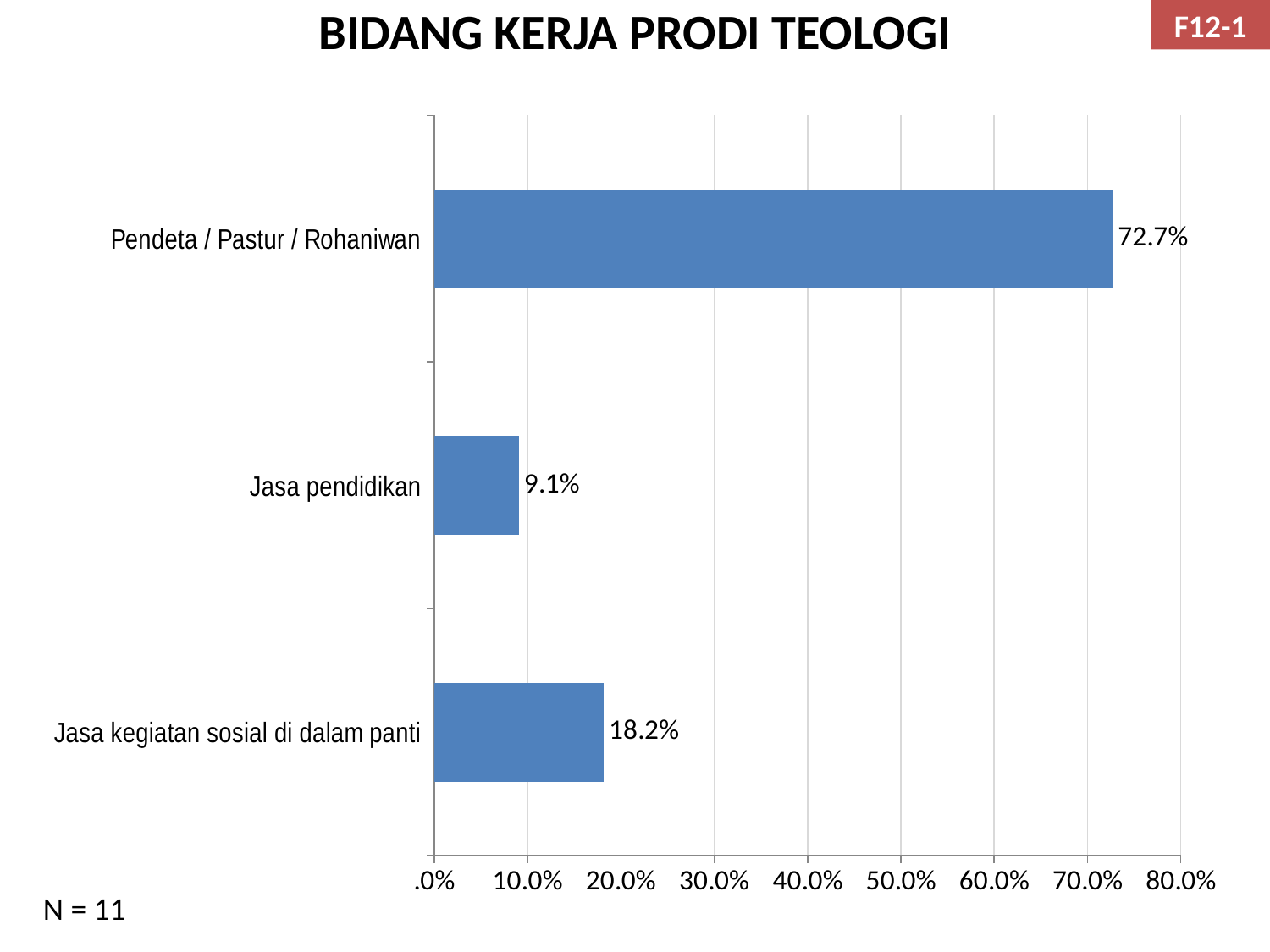
What is the difference between the values for Jasa kegiatan sosial di dalam panti and Jasa pendidikan? 9.1% What is the value for Pendeta / Pastur / Rohaniwan? 72.7% What is the value for Jasa kegiatan sosial di dalam panti? 18.2% Which category has the highest value? Pendeta / Pastur / Rohaniwan Is the value for Pendeta / Pastur / Rohaniwan greater or less than 70.0%? greater Which category has the lowest value? Jasa pendidikan What is the title of the chart? BIDANG KERJA PRODI TEOLOGI What is the difference between the values for Pendeta / Pastur / Rohaniwan and Jasa kegiatan sosial di dalam panti? 54.5% How many categories are shown in the chart? 3 Which is larger, the value for Jasa pendidikan or the value for Jasa kegiatan sosial di dalam panti? Jasa kegiatan sosial di dalam panti What kind of chart is shown on the slide? Bar chart What is the value for Jasa pendidikan? 9.1%